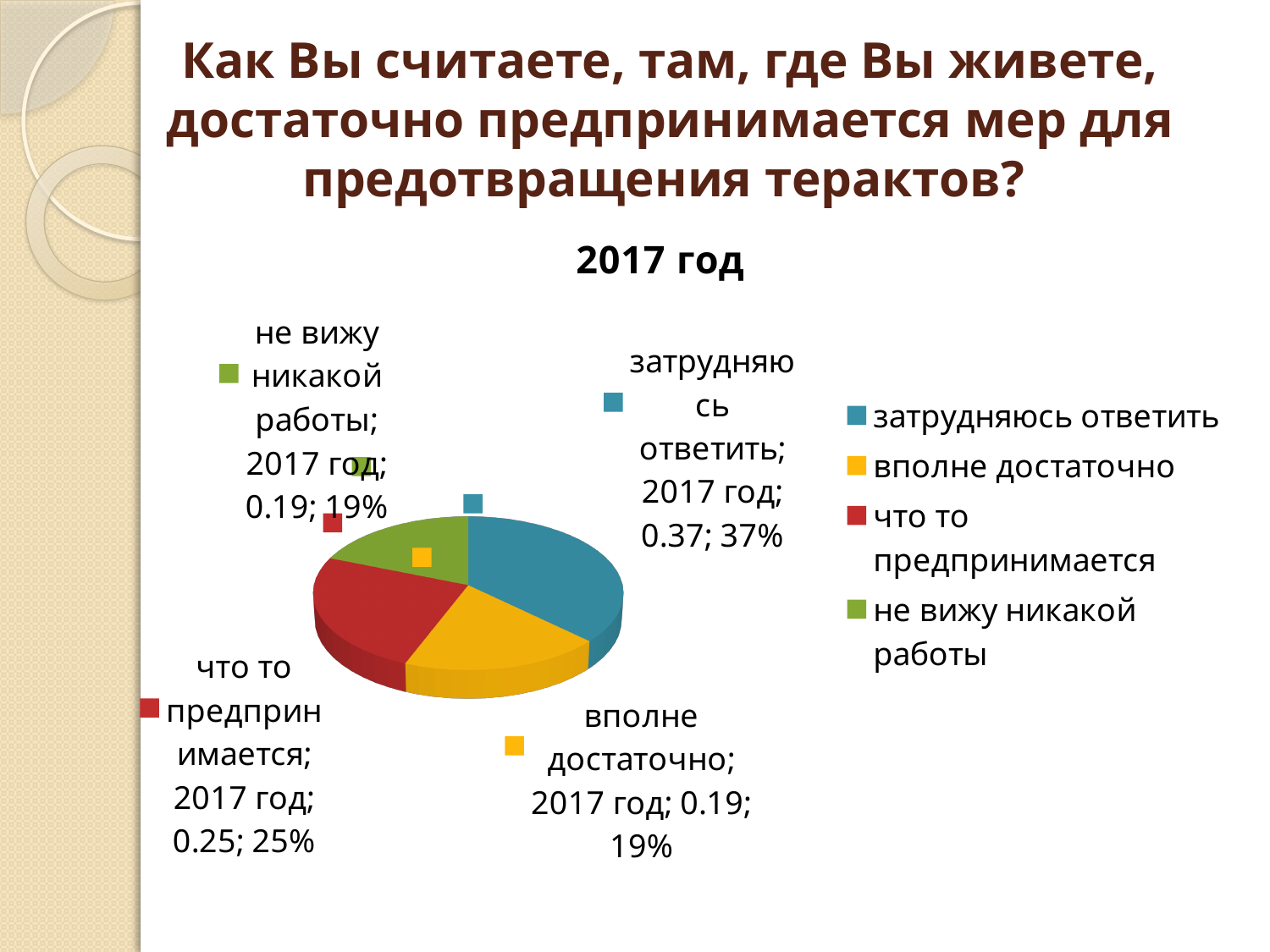
What share of the pie is "не вижу никакой работы"? 19% What share of the pie is "что то предпринимается"? 25% What colour is the slice for "затрудняюсь ответить"? blue What share of the pie is "вполне достаточно"? 19% How many slices does the pie chart have? 4 Which is larger: the share for "что то предпринимается" or the share for "вполне достаточно"? что то предпринимается What kind of chart is shown on the slide? pie chart How many entries does the legend list? 4 Which answer option has the largest share of the pie? затрудняюсь ответить What is the difference in percentage points between "затрудняюсь ответить" and "что то предпринимается"? 12 What is the chart's title? 2017 год